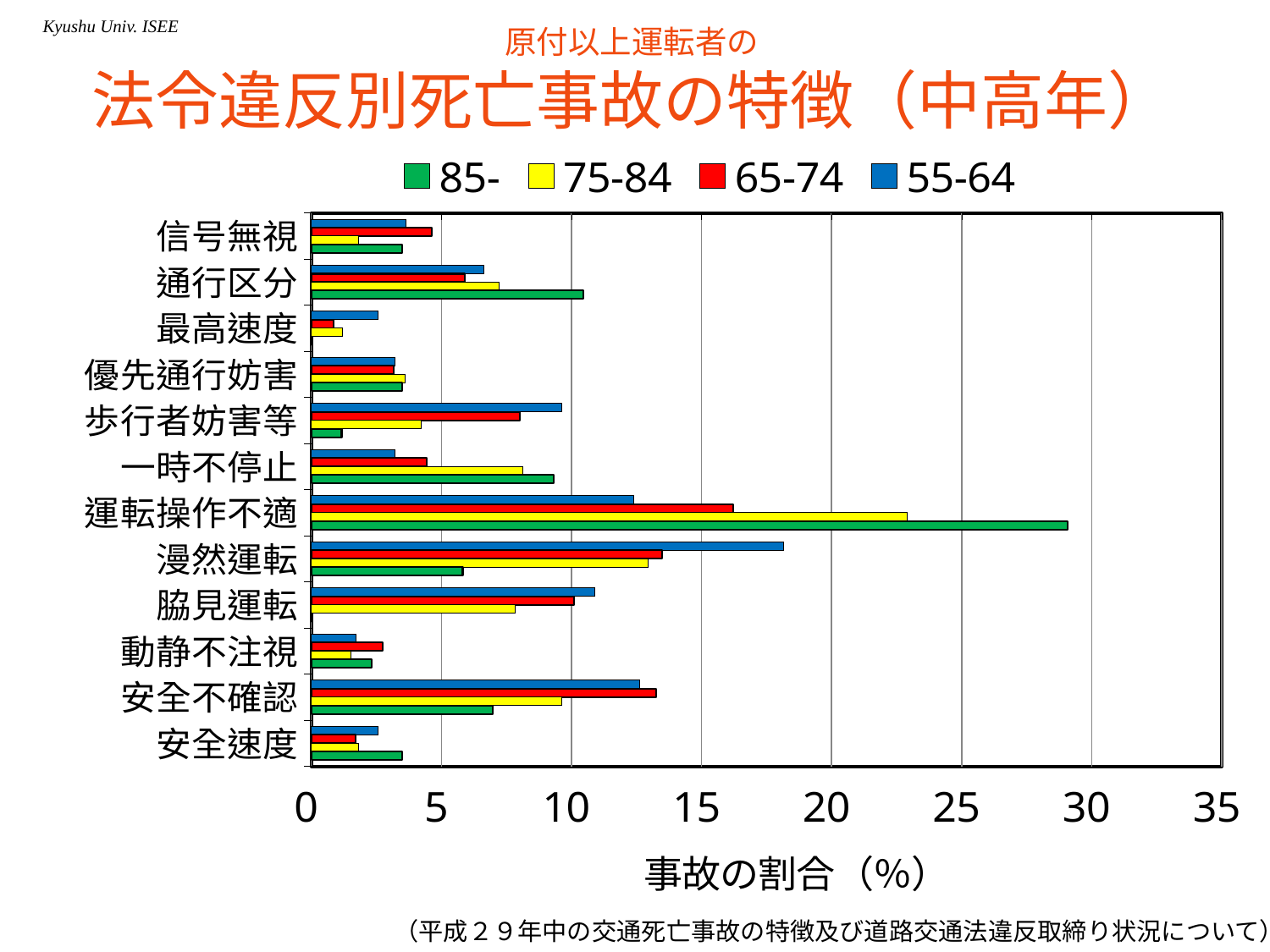
Is the value for 運転操作不適 in the 75-84 series greater or less than 20? greater For 通行区分, which series has the larger value, 85- or 65-74? 85- Is the value for 運転操作不適 in the 85- series greater or less than 25? greater What kind of chart is shown on the slide? bar chart For 歩行者妨害等, which series has the larger value, 55-64 or 85-? 55-64 Which category has the highest value for the 85- series? 運転操作不適 Which category has the highest value for the 55-64 series? 漫然運転 Is the value for 漫然運転 in the 85- series greater or less than 10? less How many violation categories are shown on the vertical axis? 12 What is the label of the horizontal axis? 事故の割合（%） How many series does the legend list? 4